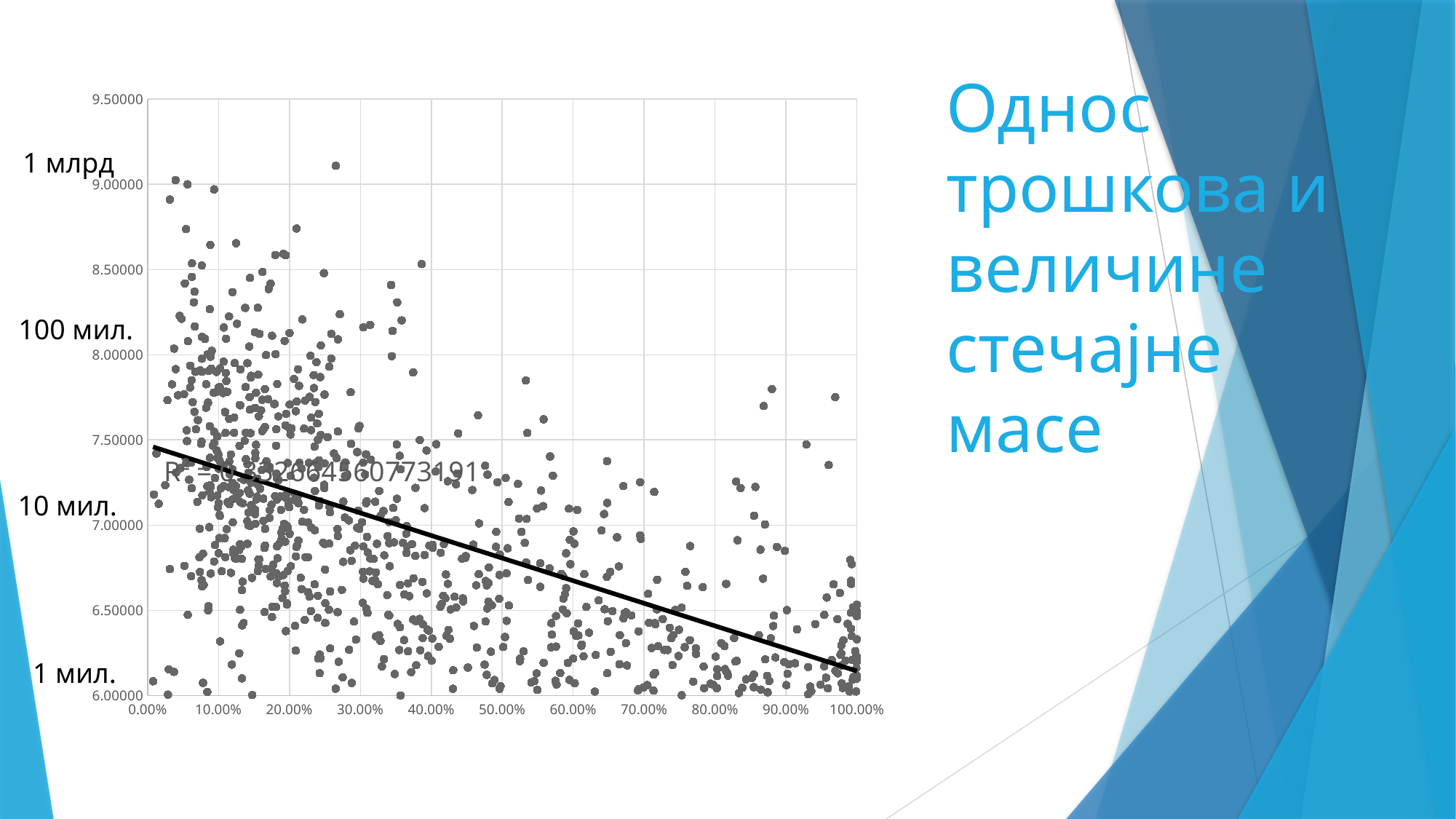
What kind of chart is shown on the slide? scatter chart What is the title of the slide containing the chart? Однос трошкова и величине стечајне масе Is the trend line's value at 100.00% on the x axis greater or less than 6.50000? less What label is written beside the y axis at the level of the 9.00000 tick? 1 млрд Is the trend line's value at 50.00% on the x axis greater or less than 7.50000? less Is the trend line's value at 0.00% on the x axis greater or less than 7.00000? greater Does the fitted trend line rise or fall as the x-axis value increases from 0.00% to 100.00%? fall